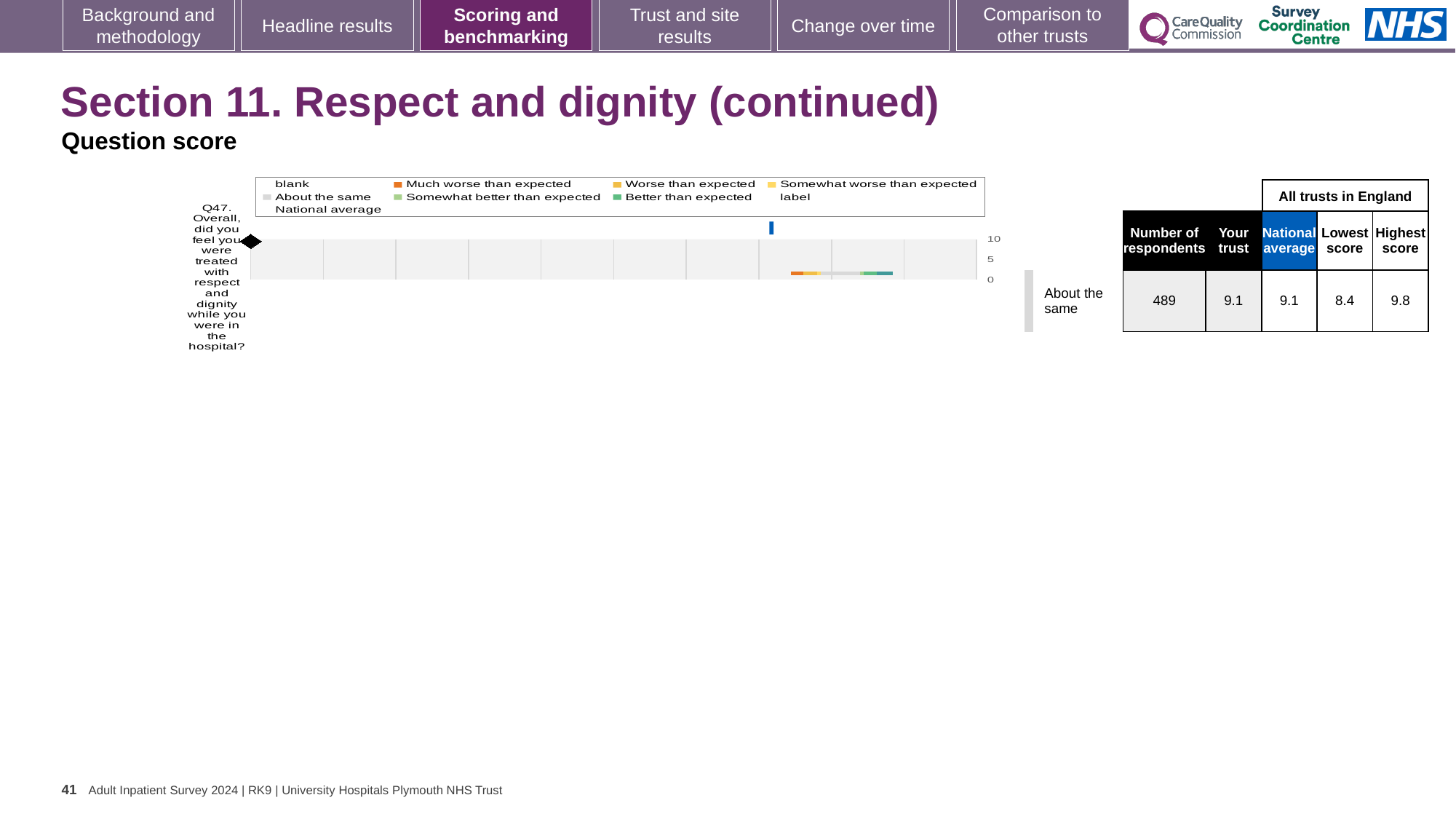
What is the difference between the 'Your trust' score and the lowest score for Q47 in the table next to the chart? 0.7 Which benchmarking category is the trust placed in for Q47? About the same In the table next to the chart, how many respondents answered Q47? 489 In the table next to the chart, what is the 'Your trust' score for Q47? 9.1 In the table next to the chart, what is the national average score for Q47? 9.1 What kind of chart is shown on the slide? bar chart What is the difference between the highest score and the lowest score for Q47 in the table next to the chart? 1.4 How many survey questions are plotted on the chart? 1 In the table next to the chart, what is the highest score among all trusts in England for Q47? 9.8 In the table next to the chart, what is the lowest score among all trusts in England for Q47? 8.4 Which survey question is plotted on the chart? Q47. Overall, did you feel you were treated with respect and dignity while you were in the hospital? How many entries does the chart's legend list? 9